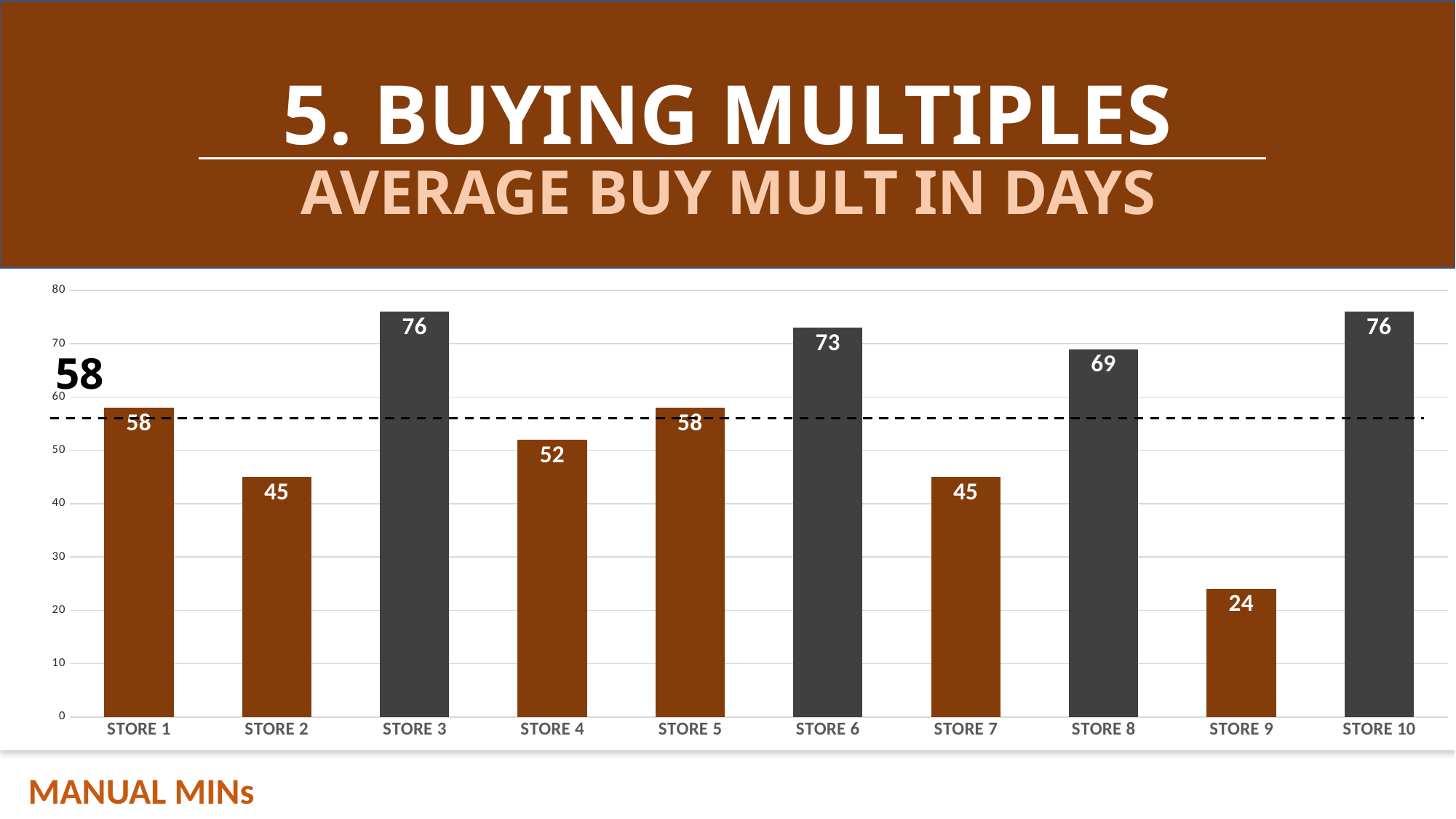
Which store has the lowest value? STORE 9 What is the difference between the values for STORE 8 and STORE 2? 24 What is the value for STORE 6? 73 What is the value for STORE 4? 52 Is the value for STORE 7 greater or less than 50? less What value is marked by the dashed horizontal line on the chart? 58 What is the difference between the values for STORE 3 and STORE 9? 52 How many stores are shown on the chart? 10 What is the subtitle of the chart shown on the slide? AVERAGE BUY MULT IN DAYS Which is larger, the value for STORE 6 or the value for STORE 8? STORE 6 What is the value for STORE 9? 24 What kind of chart is shown on the slide? bar chart